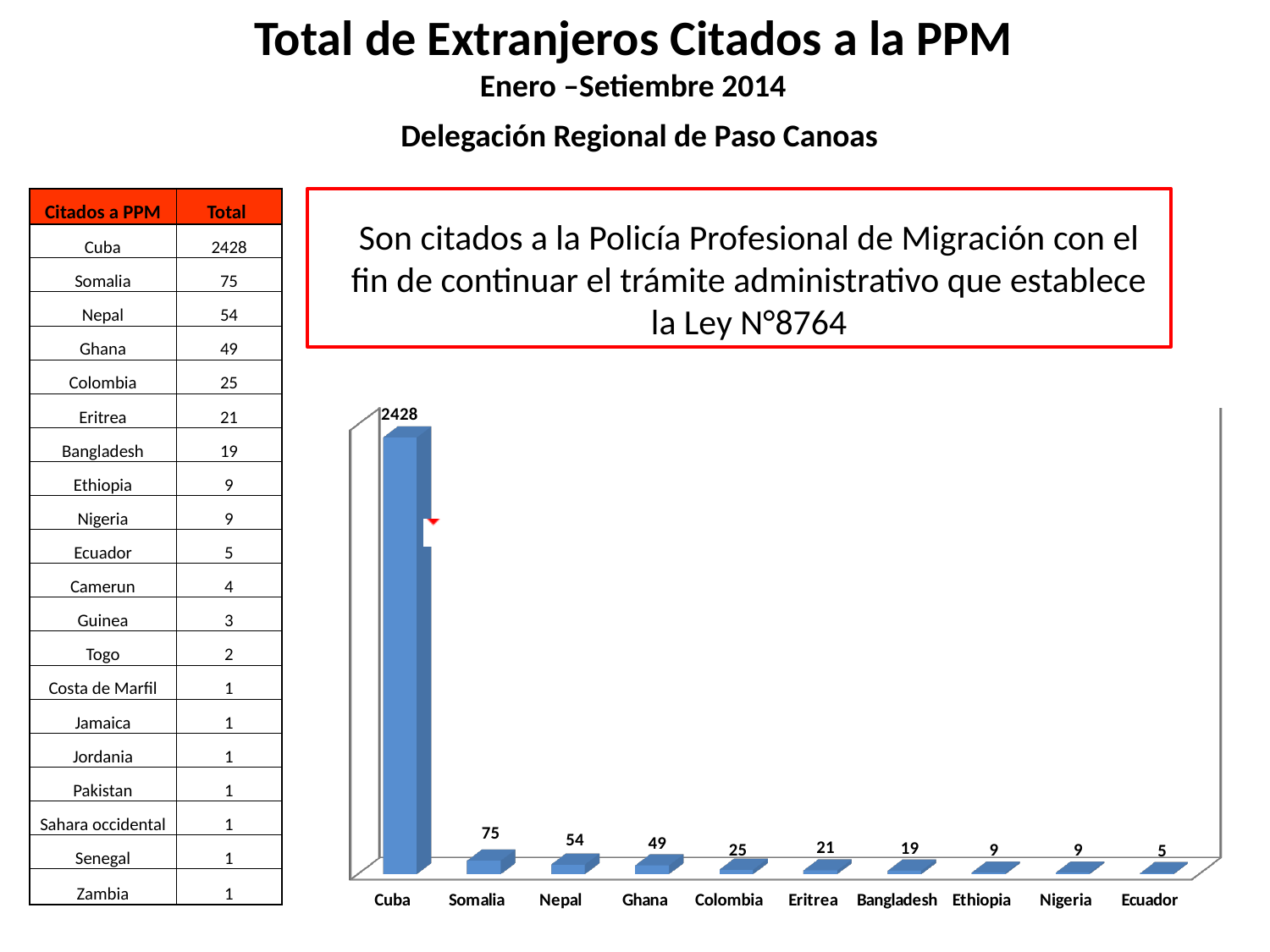
What is the difference between the values for Somalia and Nepal in the bar chart? 21 What is the difference between the values for Colombia and Eritrea in the bar chart? 4 What is the value shown for Somalia in the bar chart? 75 Which has a larger value in the bar chart, Nepal or Ghana? Nepal Do the values in the bar chart rise or fall from left to right along the x axis? Fall What kind of chart is shown on the slide? Bar chart Which country has the lowest value in the bar chart? Ecuador What is the value shown for Cuba in the bar chart? 2428 What is the value shown for Bangladesh in the bar chart? 19 How many countries are shown on the x axis of the bar chart? 10 What is the value shown for Ghana in the bar chart? 49 Which country has the highest value in the bar chart? Cuba